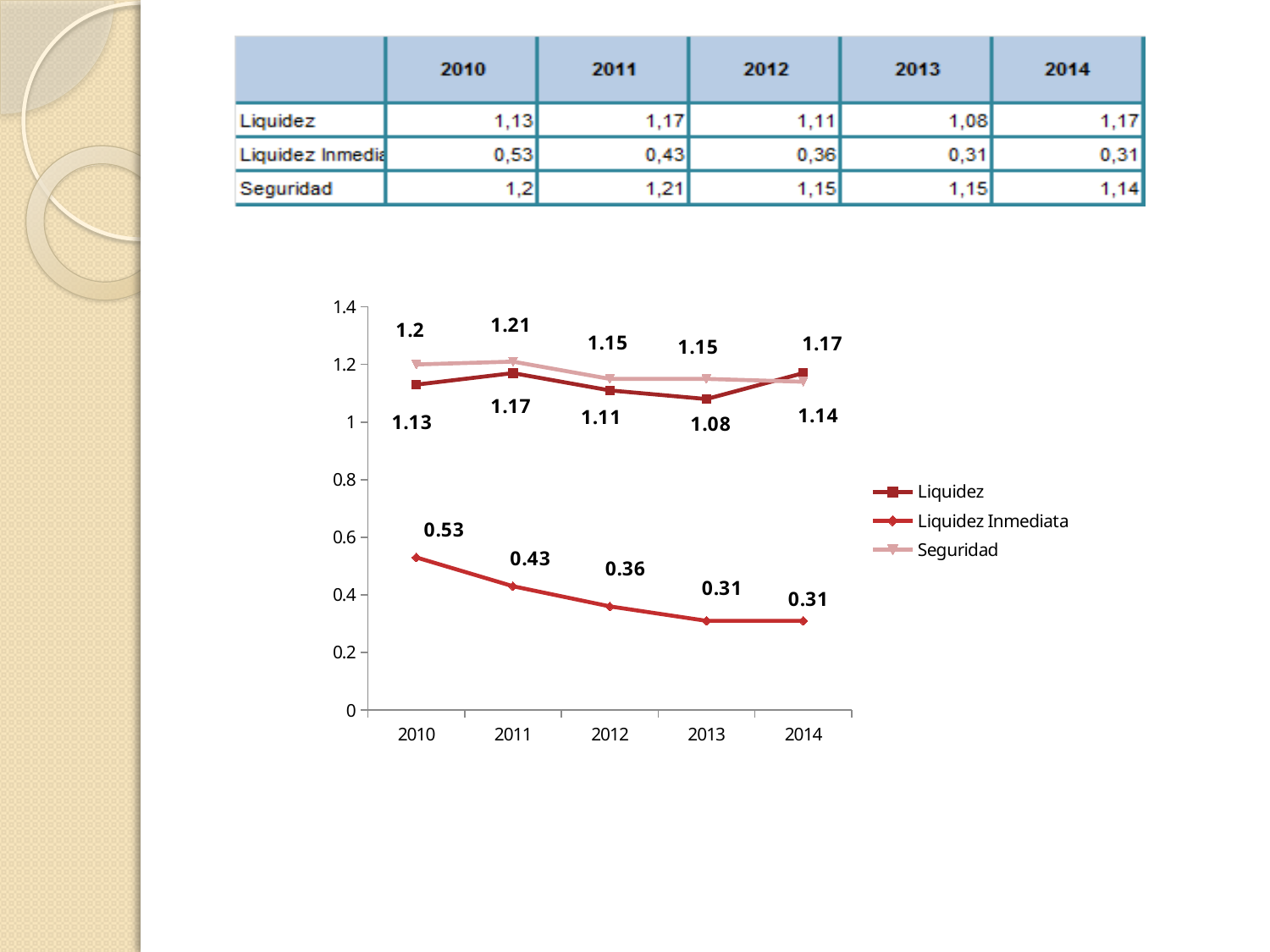
In which year is Liquidez Inmediata at its highest? 2010 What is the value of Liquidez Inmediata in 2010? 0.53 What is the value of Seguridad in 2011? 1.21 Which is larger in 2014, Liquidez or Seguridad? Liquidez How many years are plotted along the x axis of the chart? 5 What is the difference between Liquidez Inmediata in 2010 and in 2014? 0.22 What is the value of Liquidez in 2013? 1.08 What type of chart is shown on the slide? Line chart How many series does the chart's legend list? 3 In which year is Liquidez at its lowest? 2013 Does Liquidez Inmediata generally rise or fall from 2010 to 2014? Fall Which series is shown in the lightest pink colour in the legend? Seguridad